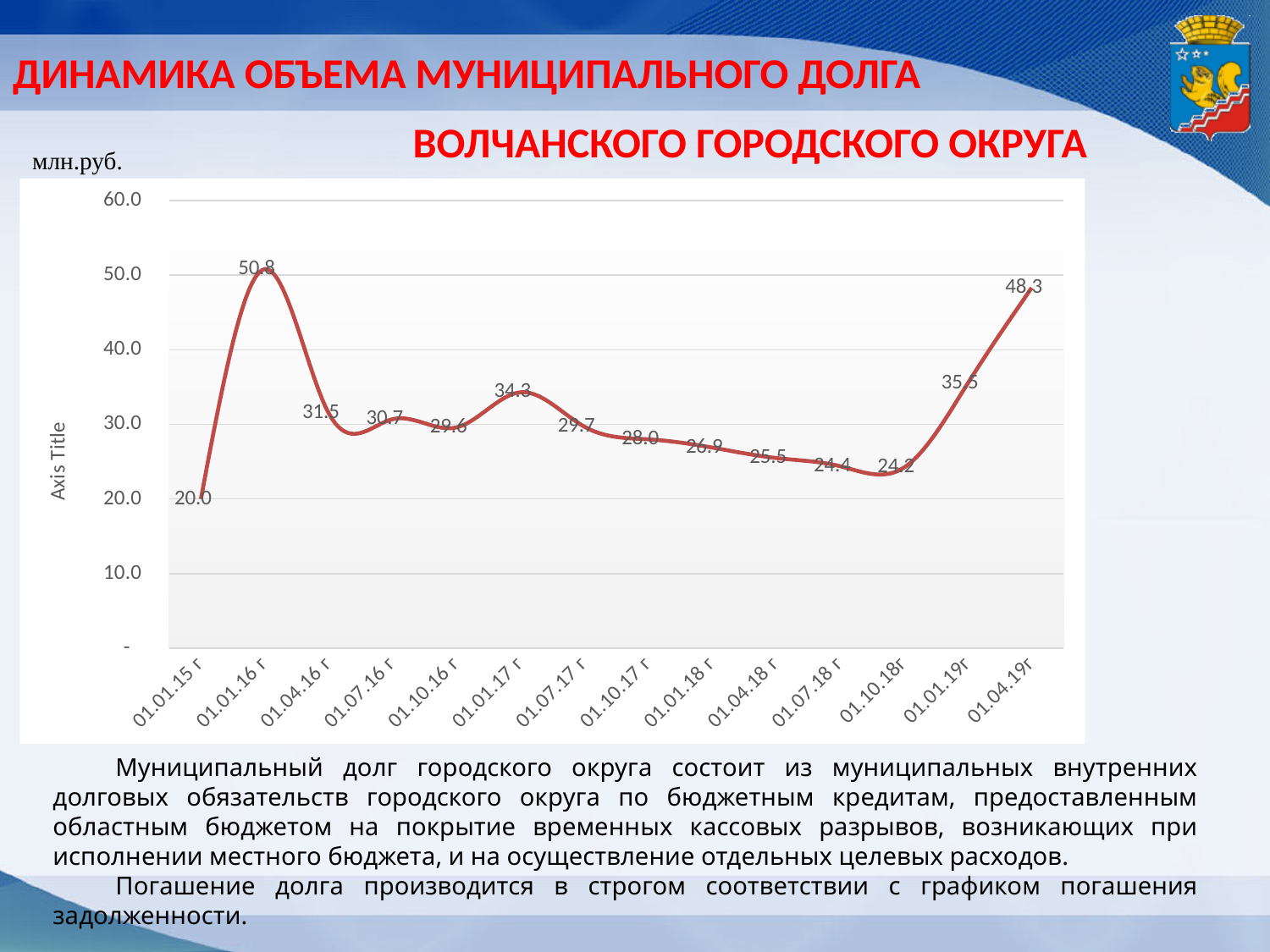
What is the value for 01.01.19г? 35.5 What is the value for 01.04.19г? 48.3 What is the value for 01.01.15 г? 20.0 What is the value for 01.01.16 г? 50.8 Which date has the highest value? 01.01.16 г Is the value for 01.10.18г greater or less than 30.0? less Which date has the lowest value? 01.01.15 г How many dates are plotted on the x axis? 14 Which is larger, the value for 01.01.17 г or the value for 01.01.19г? 01.01.19г What kind of chart is shown? line chart What is the difference between the values for 01.01.16 г and 01.04.19г? 2.5 What is the difference between the values for 01.01.19г and 01.10.18г? 11.3